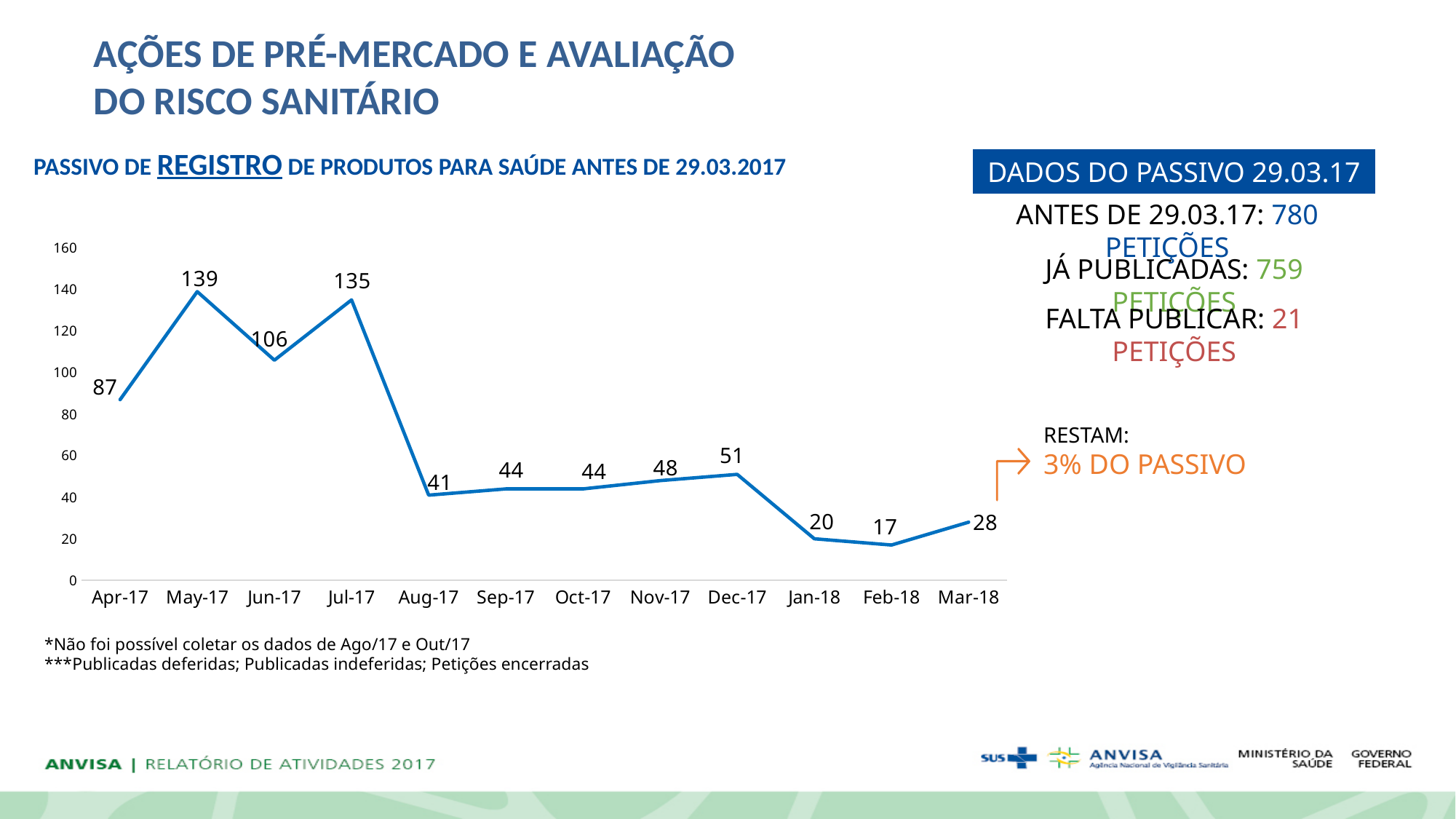
Which month has the lowest value? Feb-18 Does the line rise or fall from Dec-17 to Jan-18? fall What is the difference between the values for Jul-17 and Aug-17? 94 What is the value for Mar-18? 28 What is the value for Aug-17? 41 What is the difference between the values for Jan-18 and Feb-18? 3 Is the value for Dec-17 greater or less than 60? less Which month has the highest value? May-17 How many months are plotted on the x axis? 12 Which is larger, the value for Jun-17 or the value for Jul-17? Jul-17 What type of chart is shown on the slide? line chart What is the value for May-17? 139